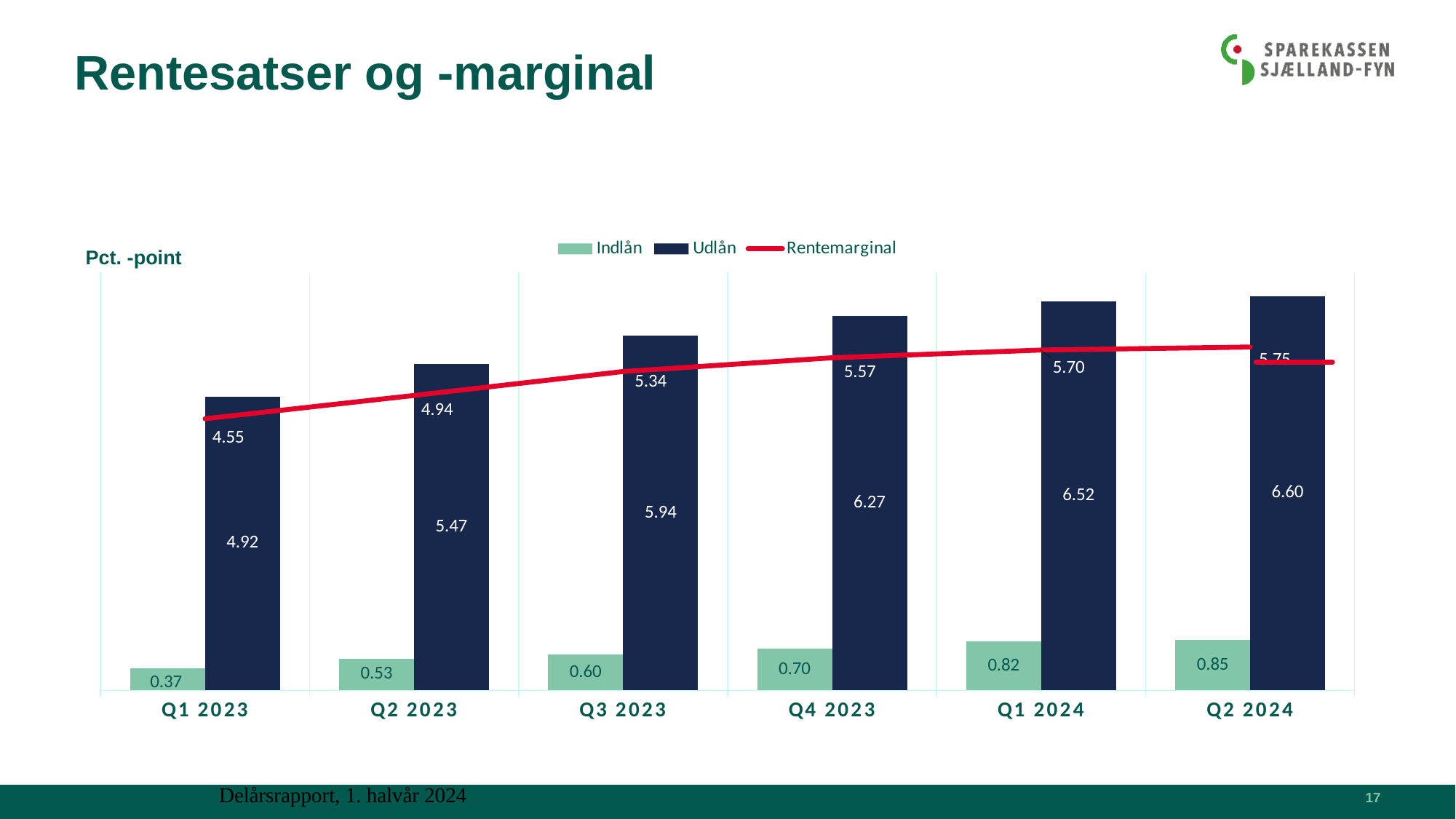
Which quarter has the highest Udlån value? Q2 2024 Do the Udlån values rise or fall from Q1 2023 to Q2 2024? Rise Which quarter has the lowest Indlån value? Q1 2023 What is the Rentemarginal value for Q4 2023? 5.57 Which series is shown as a red line? Rentemarginal What kind of chart is this? Combined bar and line chart What is the difference between the Udlån values for Q2 2024 and Q1 2023? 1.68 Which is larger, the Indlån value for Q4 2023 or for Q2 2023? Q4 2023 What is the Udlån value for Q3 2023? 5.94 How many quarters are shown on the x axis? 6 What is the Indlån value for Q1 2024? 0.82 How many series does the legend list? 3